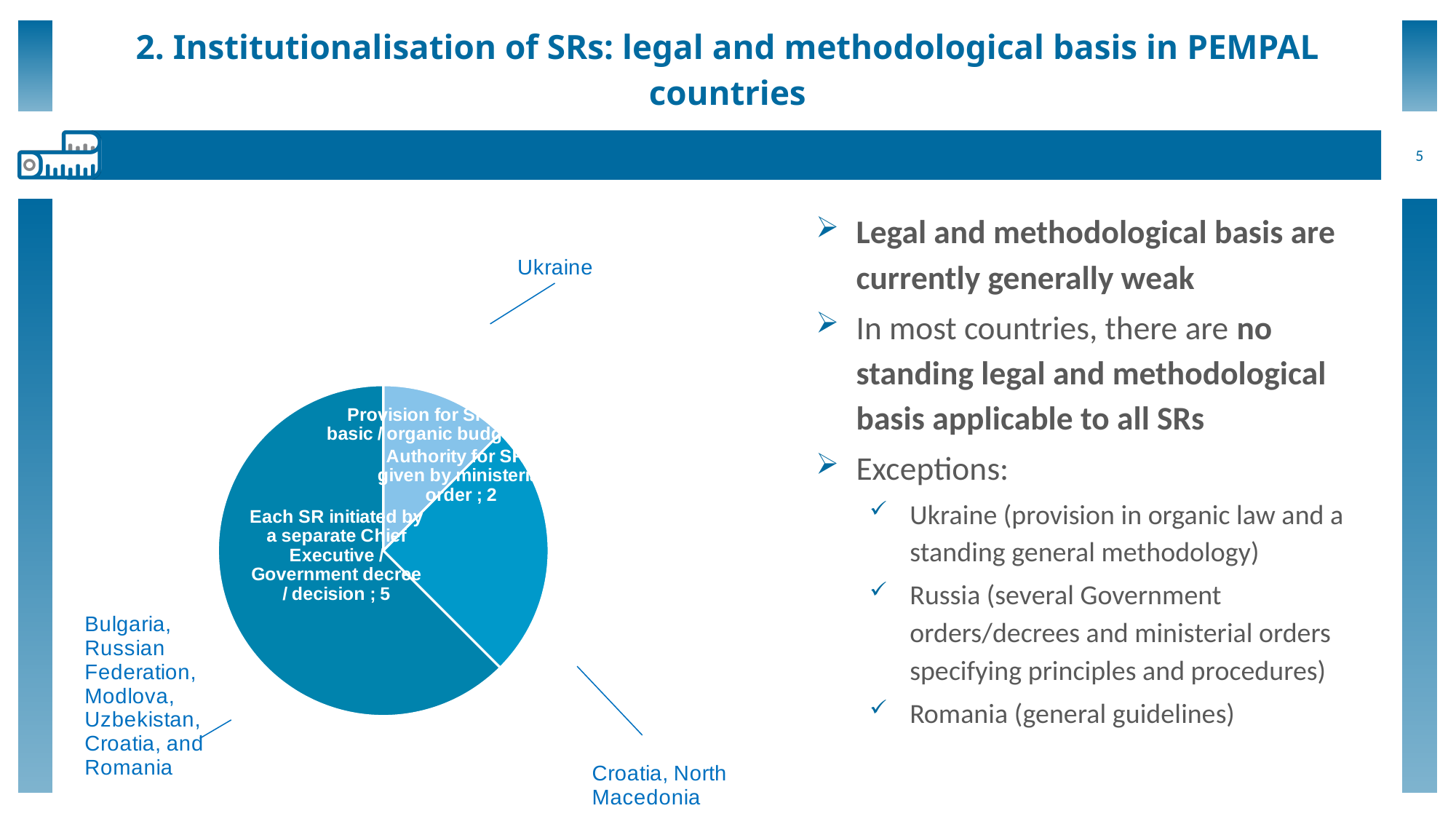
Which slice of the pie chart is the largest? Each SR initiated by a separate Chief Executive / Government decree / decision What kind of chart is shown on the slide? Pie chart What value is shown for the slice 'Authority for SRs given by ministerial order'? 2 Which country is annotated next to the smallest slice of the pie chart? Ukraine What value is shown for the slice 'Each SR initiated by a separate Chief Executive / Government decree / decision'? 5 What is the difference between the value for 'Each SR initiated by a separate Chief Executive / Government decree / decision' and the value for 'Authority for SRs given by ministerial order'? 3 How many slices does the pie chart have? 3 Which countries are annotated next to the 'Authority for SRs given by ministerial order' slice? Croatia, North Macedonia Which slice has the larger value: 'Authority for SRs given by ministerial order' or 'Each SR initiated by a separate Chief Executive / Government decree / decision'? Each SR initiated by a separate Chief Executive / Government decree / decision Which countries are annotated next to the largest slice of the pie chart? Bulgaria, Russian Federation, Modlova, Uzbekistan, Croatia, and Romania